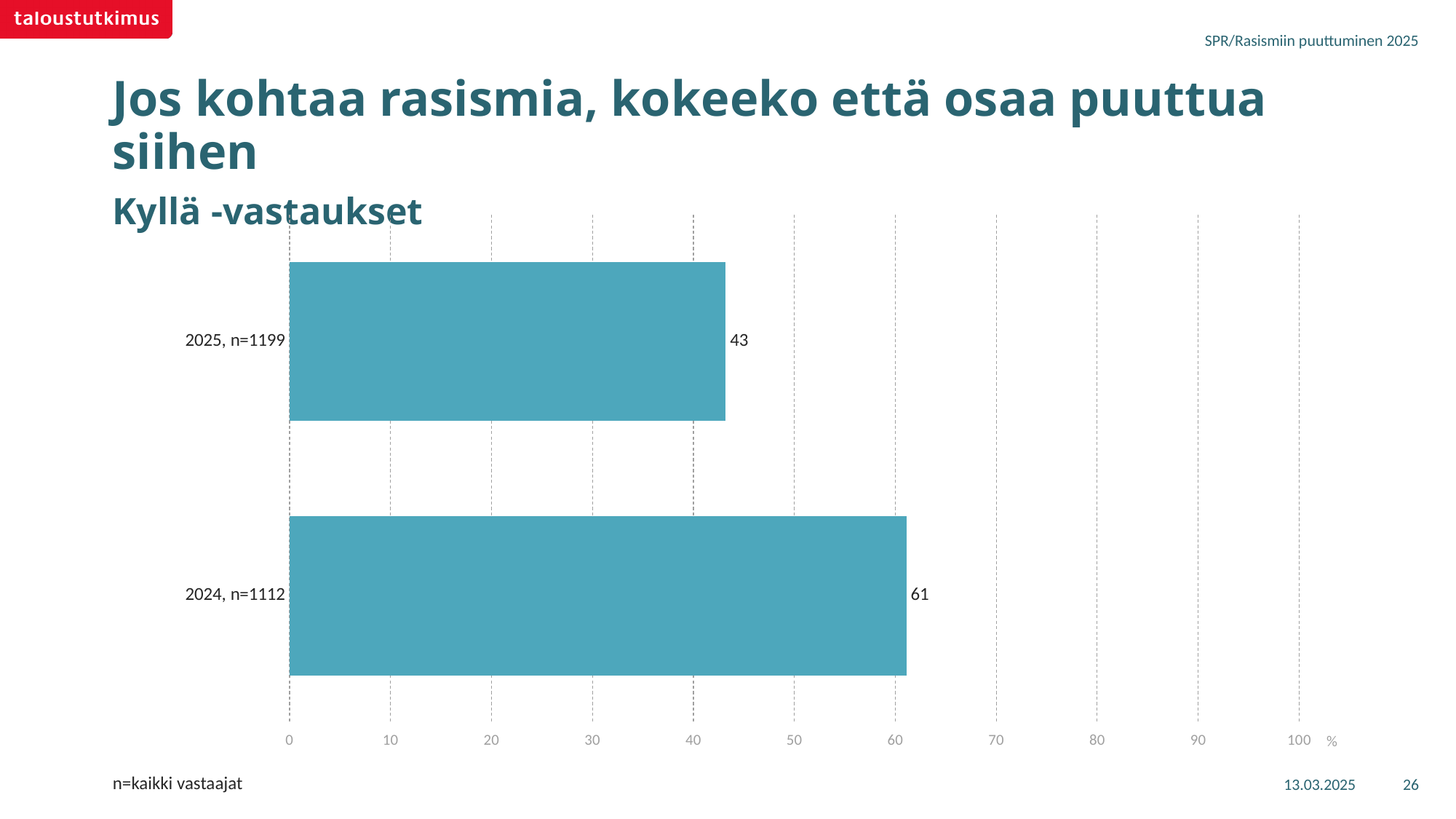
What is the difference between the values for 2024, n=1112 and 2025, n=1199? 18 What is the value for 2024, n=1112? 61 What is the value for 2025, n=1199? 43 Is the value for 2025, n=1199 greater or less than 50? less Is the value for 2024, n=1112 greater or less than 60? greater Which category has the lowest value? 2025, n=1199 How many categories are shown in the chart? 2 Which category has the highest value? 2024, n=1112 What unit is shown at the end of the horizontal axis? % Which is larger, the value for 2025, n=1199 or the value for 2024, n=1112? 2024, n=1112 What kind of chart is shown on the slide? bar chart What is the subtitle shown above the chart? Kyllä -vastaukset